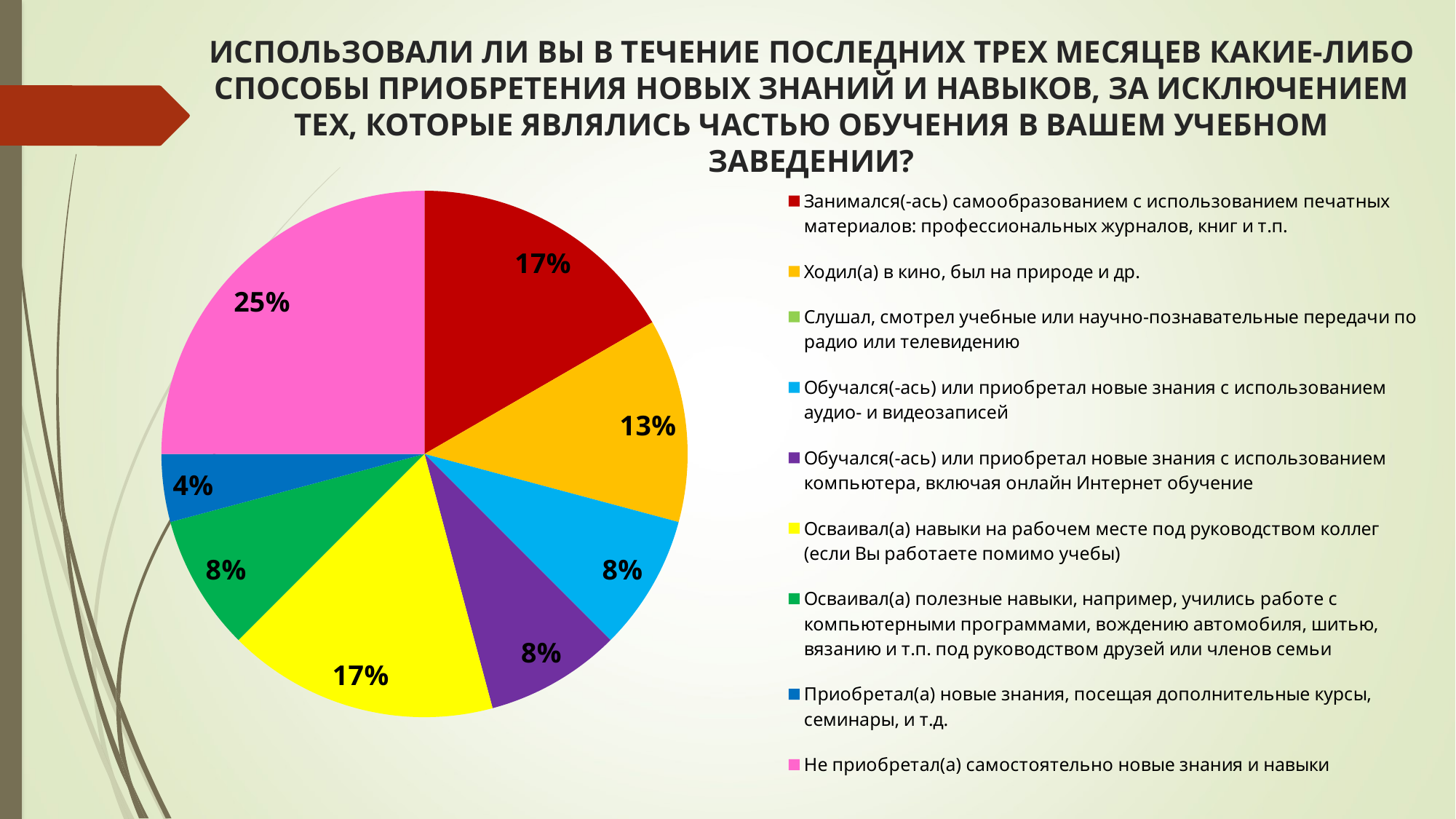
What is the difference in percentage points between "Не приобретал(а) самостоятельно новые знания и навыки" and "Ходил(а) в кино, был на природе и др."? 12 What share of the pie corresponds to "Не приобретал(а) самостоятельно новые знания и навыки"? 25% What percentage is shown for "Приобретал(а) новые знания, посещая дополнительные курсы, семинары, и т.д."? 4% Which category has the largest slice of the pie? Не приобретал(а) самостоятельно новые знания и навыки Which category has the smallest visible slice of the pie? Приобретал(а) новые знания, посещая дополнительные курсы, семинары, и т.д. What percentage is shown for "Обучался(-ась) или приобретал новые знания с использованием компьютера, включая онлайн Интернет обучение"? 8% What percentage is shown for "Занимался(-ась) самообразованием с использованием печатных материалов"? 17% What colour is the slice for "Не приобретал(а) самостоятельно новые знания и навыки"? pink What percentage is shown for "Ходил(а) в кино, был на природе и др."? 13% How many entries does the legend list? 9 What type of chart is shown on the slide? pie chart Which is larger: the slice for "Осваивал(а) навыки на рабочем месте под руководством коллег" or the slice for "Осваивал(а) полезные навыки ... под руководством друзей или членов семьи"? Осваивал(а) навыки на рабочем месте под руководством коллег